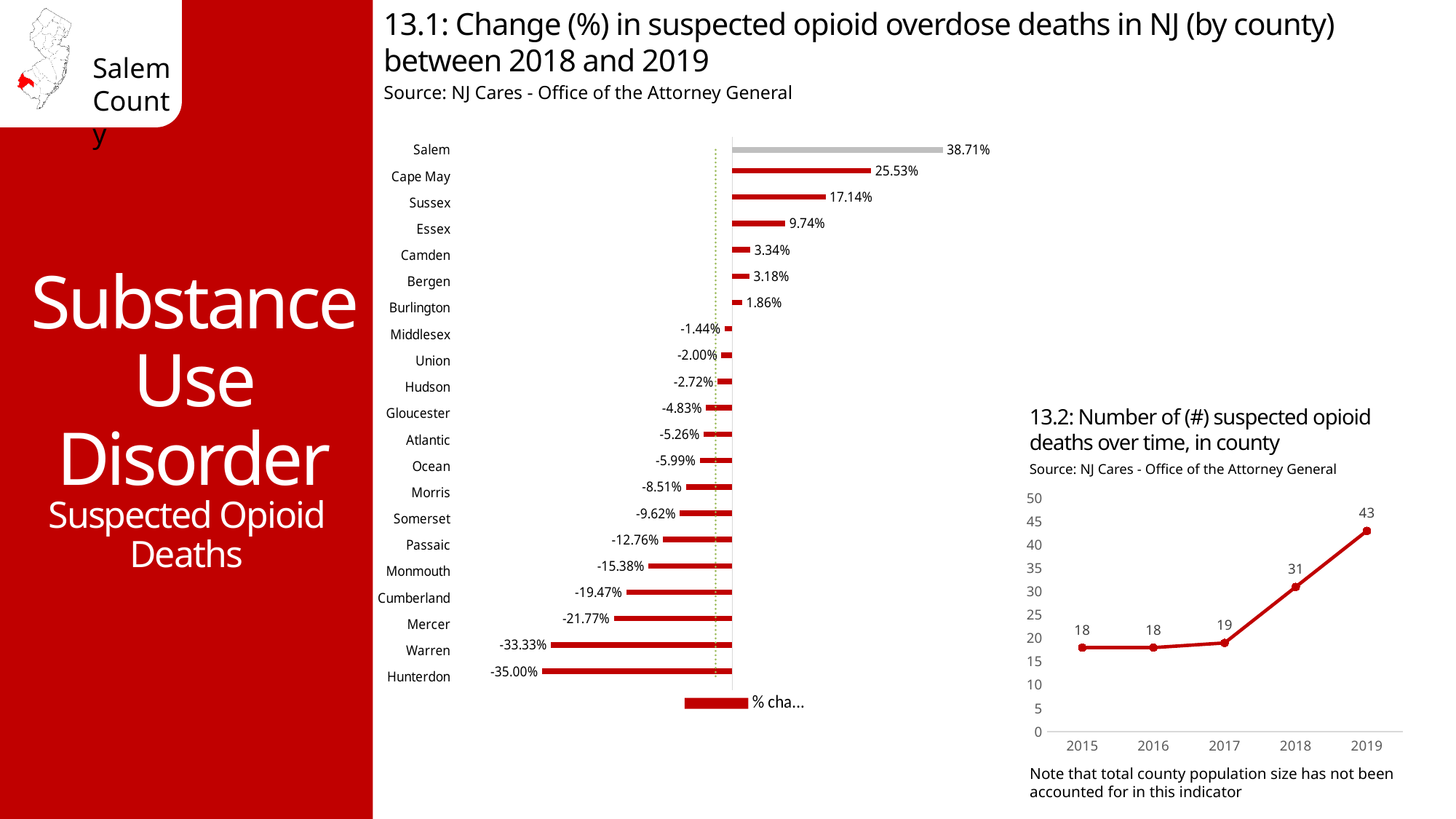
In chart 13.1, how many counties are plotted? 21 What kind of chart is chart 13.1? Bar chart In chart 13.1, which county has the highest percentage change? Salem In chart 13.2, what is the difference in suspected opioid deaths between 2018 and 2019? 12 In chart 13.1, what is the value shown for Cumberland? -19.47% In chart 13.2, which year has the lowest number of suspected opioid deaths? 2015 and 2016 (both 18) In chart 13.1, which has the larger percentage change, Cape May or Sussex? Cape May In chart 13.2, do the values rise or fall from 2017 to 2019? Rise In chart 13.1, which county has the lowest percentage change? Hunterdon In chart 13.2, how many suspected opioid deaths were there in 2019? 43 What kind of chart is chart 13.2? Line chart In chart 13.1, what is the percentage change in suspected opioid overdose deaths for Salem? 38.71%